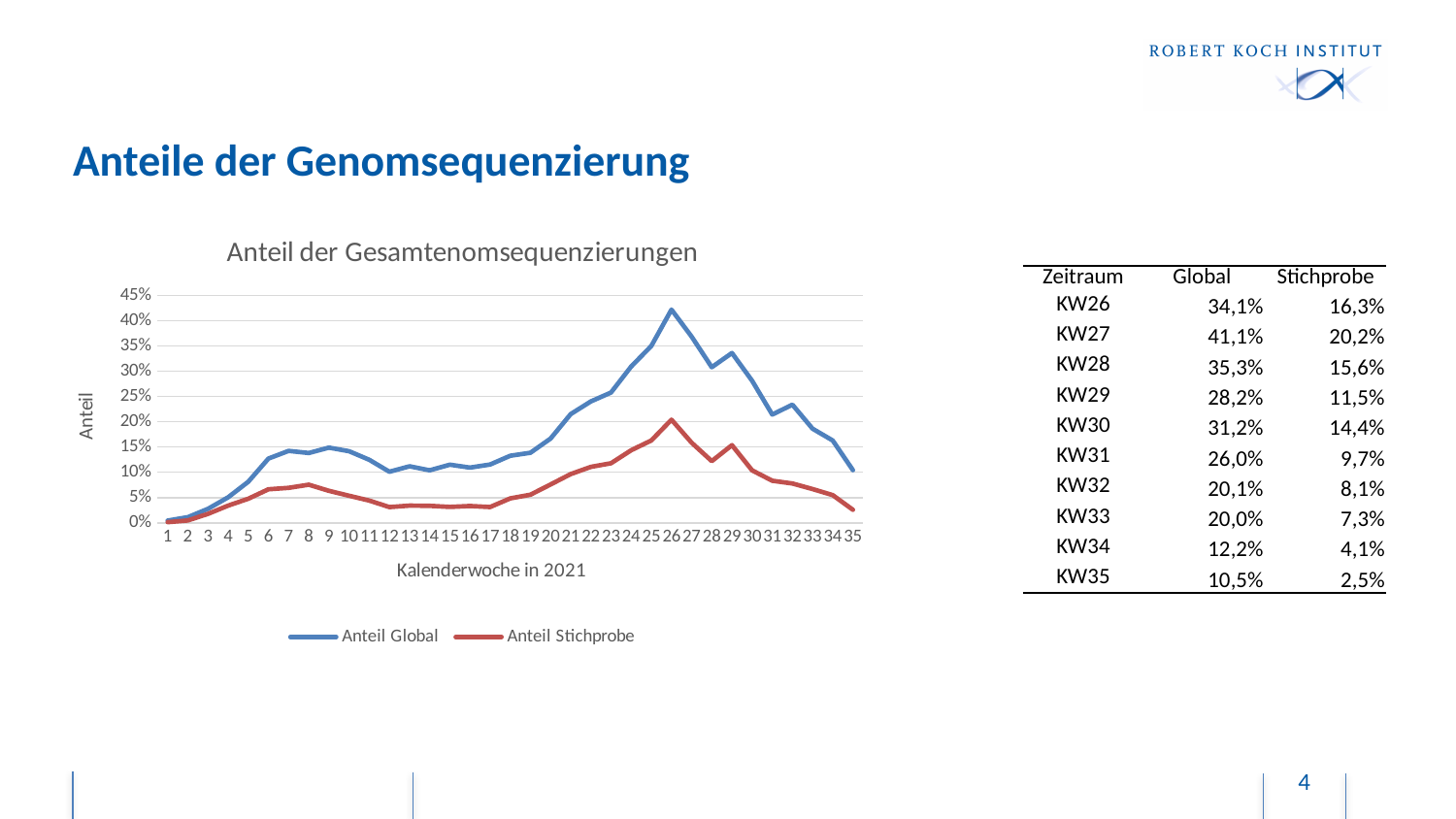
What kind of chart is shown on the slide? Line chart At calendar week 26, which series has the larger value, Anteil Global or Anteil Stichprobe? Anteil Global How many calendar weeks are plotted along the x axis of the chart? 35 Is the value of Anteil Stichprobe at calendar week 35 greater or less than 5%? less In which calendar week does the Anteil Global line reach its highest value? 26 From calendar week 26 to week 35, does the Anteil Global line rise or fall? fall Is the value of Anteil Global at calendar week 26 greater or less than 40%? greater According to the table on the slide, what is the Global value for KW27? 41,1% What is the title of the chart? Anteil der Gesamtenomsequenzierungen What are the two series named in the chart legend? Anteil Global and Anteil Stichprobe How many series does the chart legend list? 2 According to the table on the slide, what is the difference between the Global and Stichprobe values for KW26? 17,8%